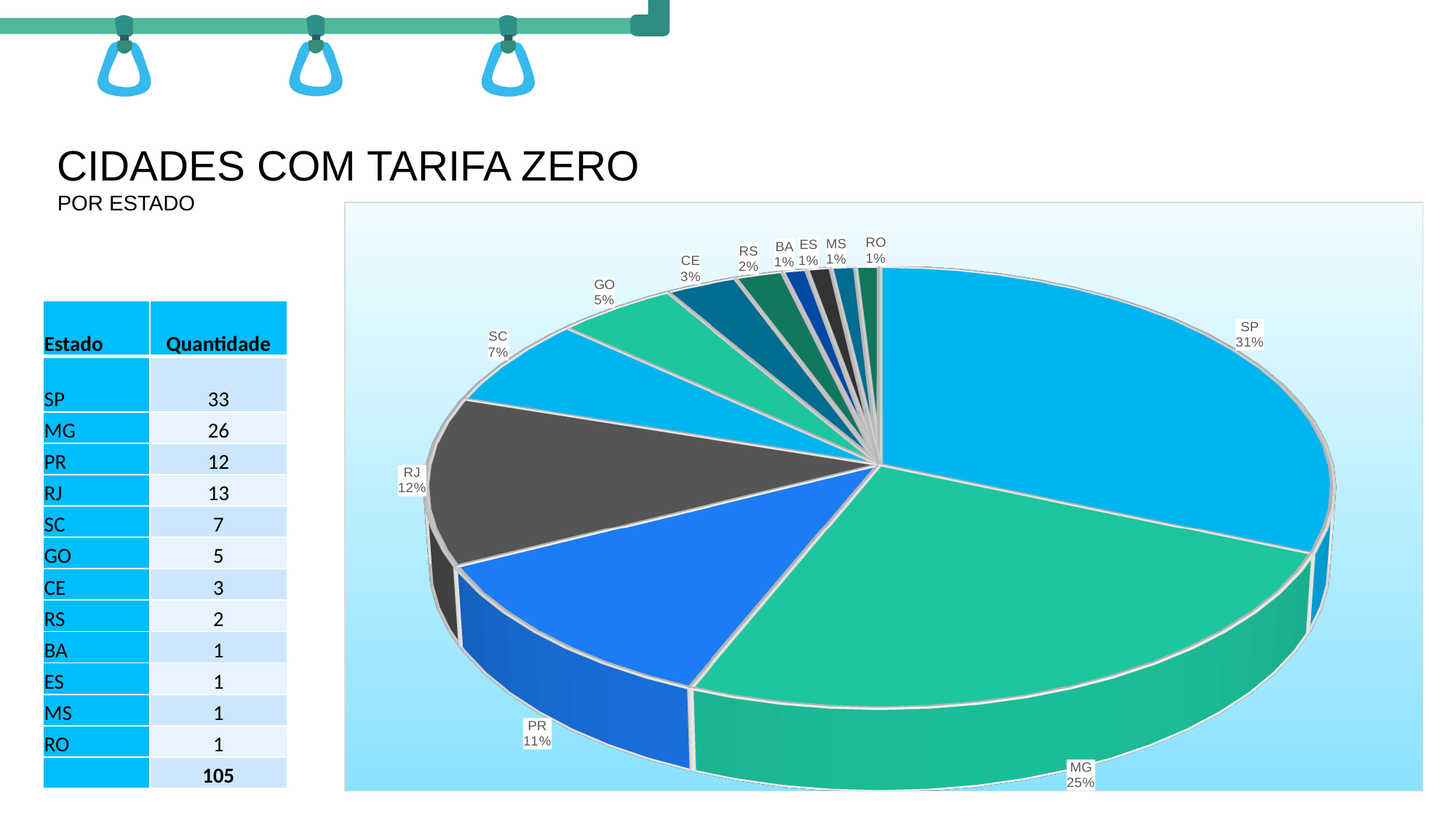
What is the difference in percentage points between the SP slice and the MG slice? 6 What share of the pie does SP represent? 31% What percentage is shown for CE in the pie chart? 3% Which slice is larger, MG or RJ? MG What percentage is shown for RJ in the pie chart? 12% What is the title of the slide containing the pie chart? CIDADES COM TARIFA ZERO Which slice is larger, SC or GO? SC What percentage is shown for SC in the pie chart? 7% What percentage is shown for MG in the pie chart? 25% What kind of chart is shown on the slide? pie chart How many slices does the pie chart have? 12 Which state has the largest slice of the pie chart? SP